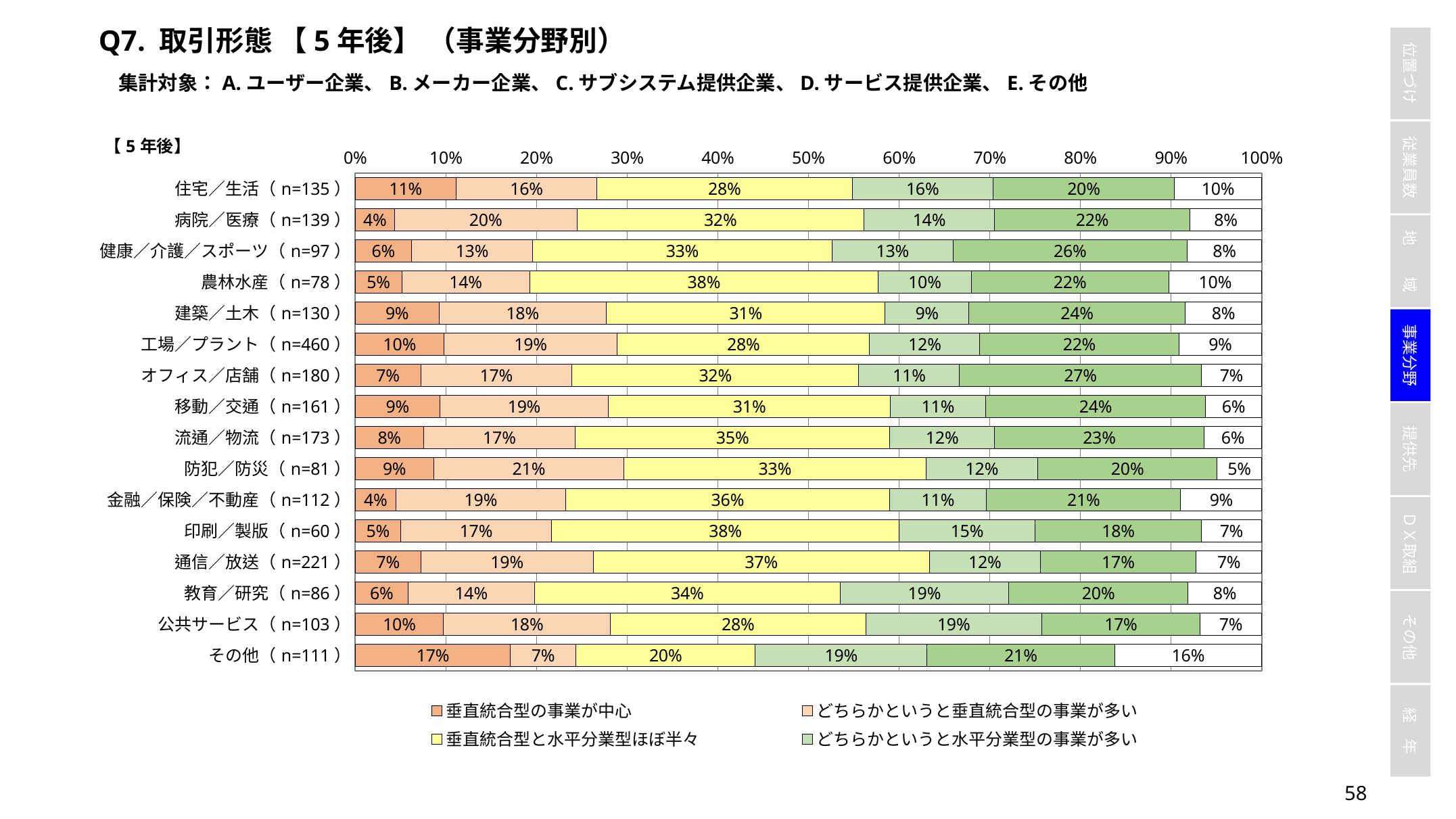
What is the value of 垂直統合型と水平分業型ほぼ半々 for 病院／医療 (n=139)? 32% What is the sample size (n) shown for 工場／プラント? n=460 What kind of chart is shown on the slide? stacked bar chart What is the difference between the 垂直統合型と水平分業型ほぼ半々 values for 農林水産 (n=78) and 住宅／生活 (n=135)? 10 percentage points How many series does the legend list? 4 What is the value of どちらかというと水平分業型の事業が多い for 教育／研究 (n=86)? 19% What is the value of 垂直統合型の事業が中心 for 住宅／生活 (n=135)? 11% How many business-field categories (rows) are plotted in the chart? 16 Which category has the lowest value for 垂直統合型と水平分業型ほぼ半々? その他 (n=111) Which is larger: the どちらかというと垂直統合型の事業が多い value for 防犯／防災 (n=81) or for 健康／介護／スポーツ (n=97)? 防犯／防災 (n=81) Which category has the highest value for 垂直統合型の事業が中心? その他 (n=111)